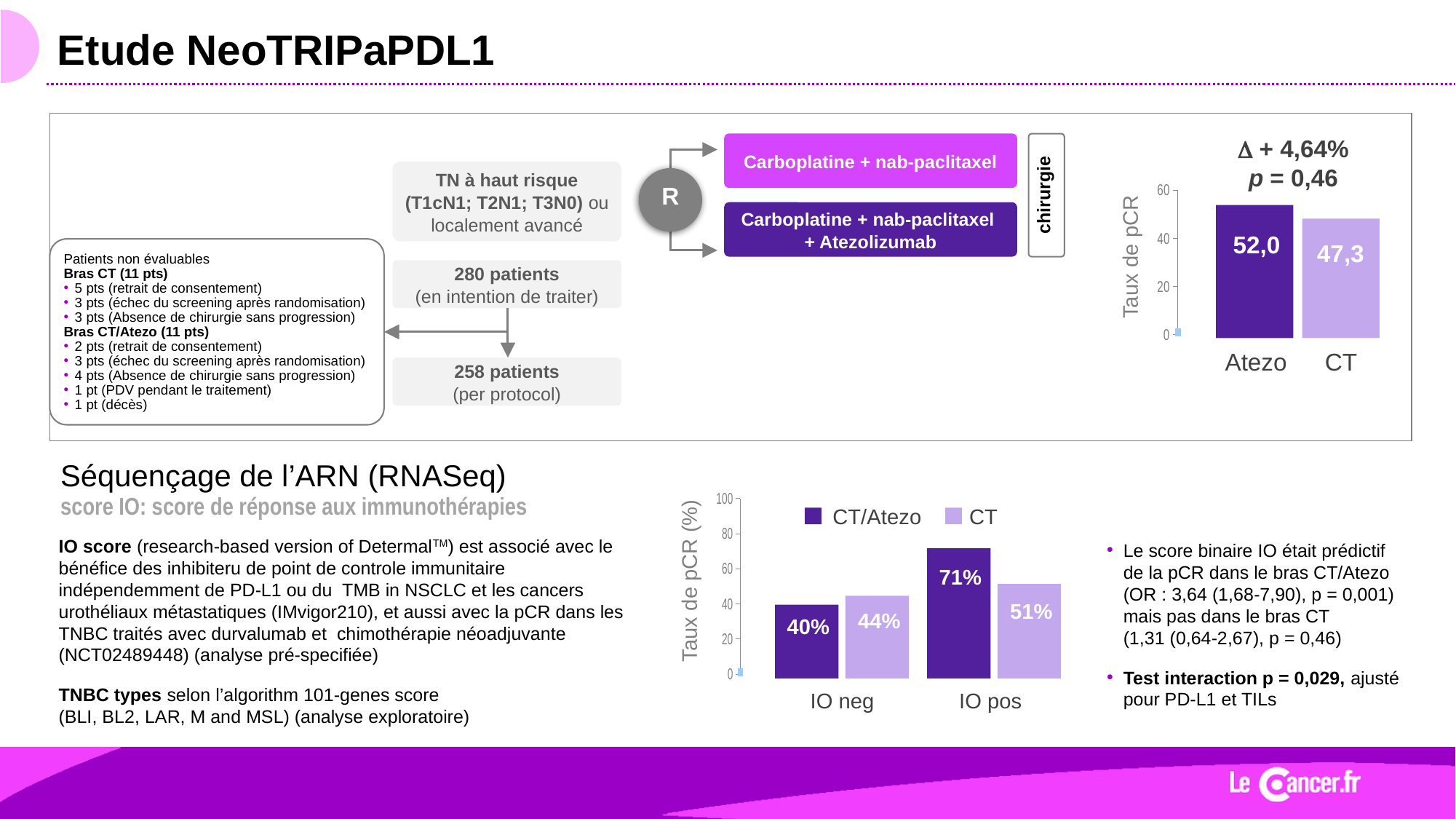
In the bottom chart of pCR rate by IO score, how many series does the legend list? 2 In the top-right chart of pCR rate (Taux de pCR), what is the value for Atezo? 52,0 In the bottom chart of pCR rate by IO score, what is the difference between CT/Atezo and CT in the IO pos group? 20% In the top-right chart of pCR rate (Taux de pCR), how many bars are plotted? 2 In the top-right chart of pCR rate (Taux de pCR), which bar is higher, Atezo or CT? Atezo In the bottom chart of pCR rate by IO score, which series is shown in dark purple? CT/Atezo What kind of chart is the top-right chart of pCR rate (Taux de pCR)? Bar chart In the bottom chart of pCR rate by IO score, what is the value for CT/Atezo in the IO pos group? 71% In the top-right chart of pCR rate (Taux de pCR), what is the value for CT? 47,3 In the bottom chart of pCR rate by IO score, what is the value for CT/Atezo in the IO neg group? 40% In the bottom chart of pCR rate by IO score, what is the value for CT in the IO pos group? 51% In the bottom chart of pCR rate by IO score, which bar is the highest? CT/Atezo in IO pos (71%)